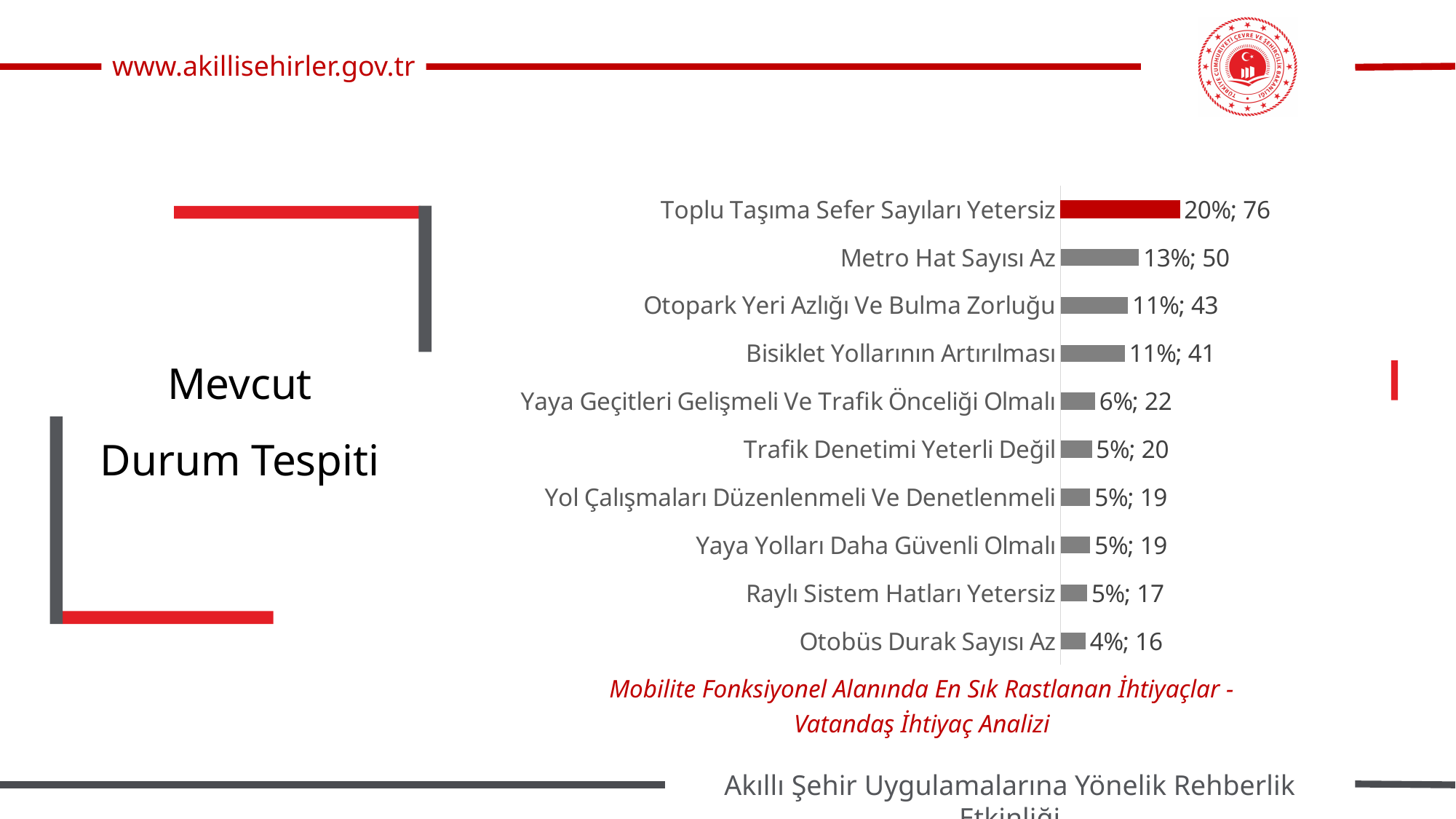
How many categories does the chart show? 10 What is the difference in count between "Trafik Denetimi Yeterli Değil" and "Raylı Sistem Hatları Yetersiz"? 3 What count is shown for "Bisiklet Yollarının Artırılması"? 41 What percentage is shown for "Yaya Geçitleri Gelişmeli Ve Trafik Önceliği Olmalı"? 6% Which category has the lowest value? Otobüs Durak Sayısı Az What is the data label for "Metro Hat Sayısı Az"? 13%; 50 What is the data label for "Toplu Taşıma Sefer Sayıları Yetersiz"? 20%; 76 What is the difference in count between "Toplu Taşıma Sefer Sayıları Yetersiz" and "Metro Hat Sayısı Az"? 26 What is the title of the chart? Mobilite Fonksiyonel Alanında En Sık Rastlanan İhtiyaçlar - Vatandaş İhtiyaç Analizi Which category has the highest value? Toplu Taşıma Sefer Sayıları Yetersiz Which has a larger count, "Otopark Yeri Azlığı Ve Bulma Zorluğu" or "Bisiklet Yollarının Artırılması"? Otopark Yeri Azlığı Ve Bulma Zorluğu What kind of chart is shown on the slide? bar chart